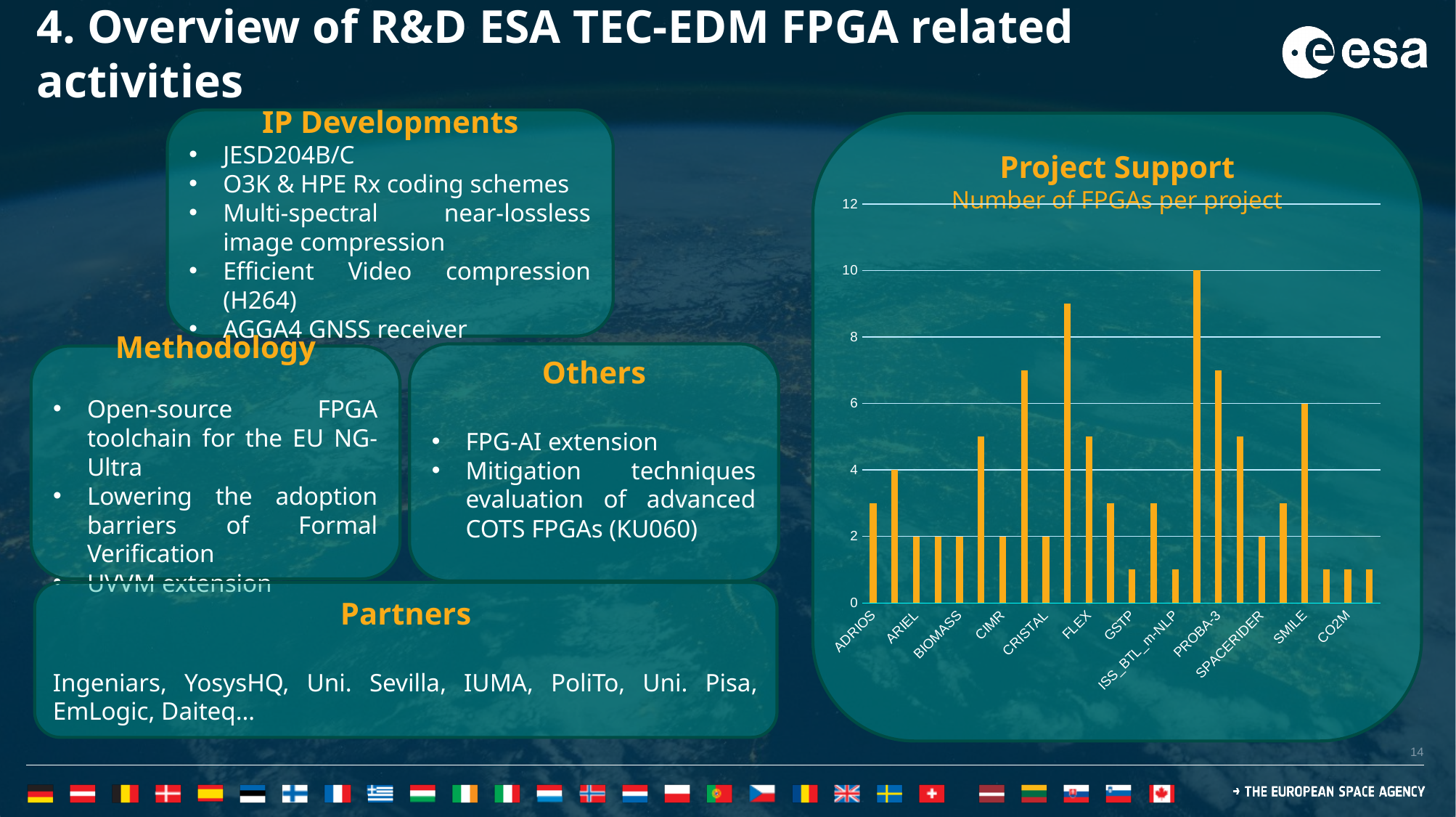
In the 'Number of FPGAs per project' chart, is the value for CO2M greater or less than 2? less In the 'Number of FPGAs per project' chart, is the value for ADRIOS greater or less than 4? less What kind of chart is shown under 'Project Support'? bar chart What is the maximum value shown on the vertical axis of the 'Number of FPGAs per project' chart? 12 In the 'Number of FPGAs per project' chart, is the value for PROBA-3 greater or less than 6? greater In the 'Number of FPGAs per project' chart, which has the larger value, PROBA-3 or ARIEL? PROBA-3 What is the highest value reached by any bar in the 'Number of FPGAs per project' chart? 10 What is the subtitle of the 'Project Support' chart? Number of FPGAs per project How many project labels are readable on the x axis of the 'Number of FPGAs per project' chart? 12